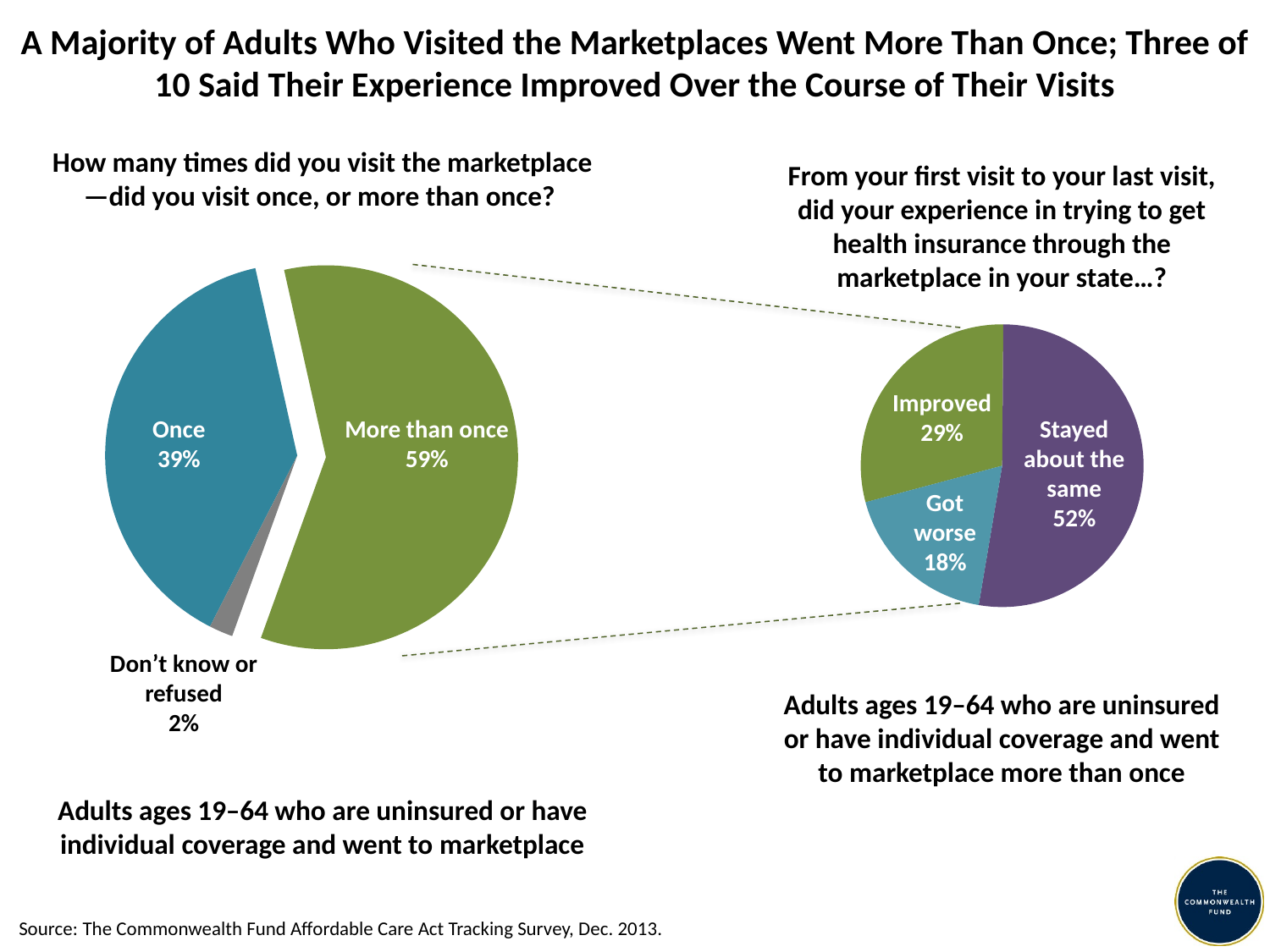
How many slices does the right pie chart (From your first visit to your last visit...) have? 3 In the left pie chart (How many times did you visit the marketplace), what is the difference in percentage points between 'More than once' and 'Once'? 20 percentage points In the right pie chart (From your first visit to your last visit...), which is larger: 'Improved' or 'Got worse'? Improved In the left pie chart (How many times did you visit the marketplace), what share of adults visited once? 39% In the left pie chart (How many times did you visit the marketplace), what share of adults visited more than once? 59% In the left pie chart (How many times did you visit the marketplace), what share answered 'Don't know or refused'? 2% What type of chart is used on the left side of the slide? Pie chart In the right pie chart (From your first visit to your last visit...), what share said their experience got worse? 18% In the left pie chart (How many times did you visit the marketplace), which category has the smallest share? Don't know or refused In the left pie chart (How many times did you visit the marketplace), which category has the largest share? More than once In the right pie chart (From your first visit to your last visit...), what share said their experience improved? 29% In the right pie chart (From your first visit to your last visit...), which category has the largest share? Stayed about the same